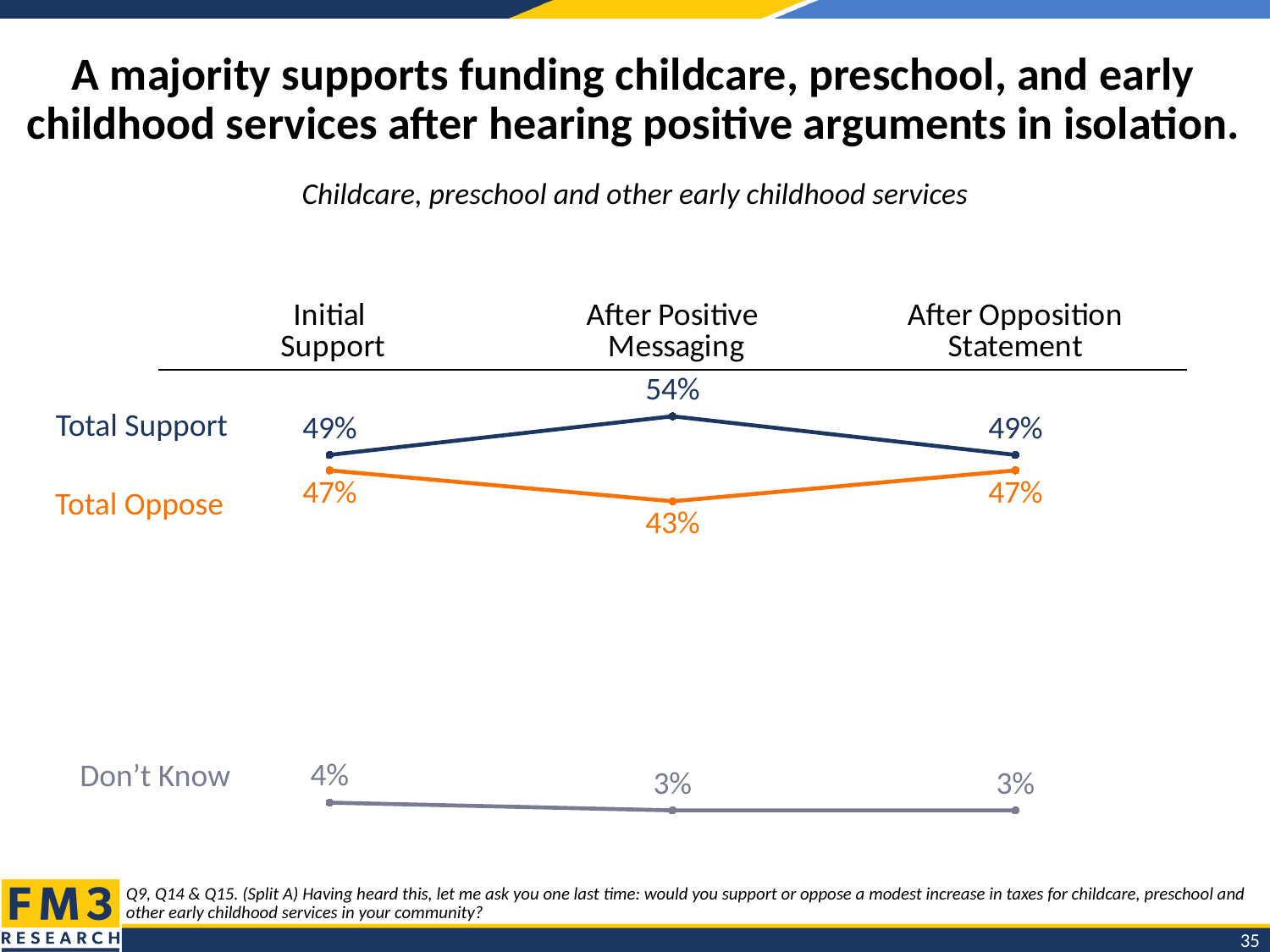
How many stages are shown along the x axis? 3 What is the Don't Know value at the Initial Support stage? 4% What is the Total Support value After Positive Messaging? 54% What is the Total Oppose value After Positive Messaging? 43% What is the Total Oppose value After Opposition Statement? 47% At which stage is Total Oppose lowest? After Positive Messaging What kind of chart is shown on the slide? Line chart How many series are plotted on the chart? 3 Which is larger at the Initial Support stage, Total Support or Total Oppose? Total Support What is the Total Support value at the Initial Support stage? 49% At which stage is Total Support highest? After Positive Messaging What is the difference between Total Support and Total Oppose After Positive Messaging? 11 percentage points